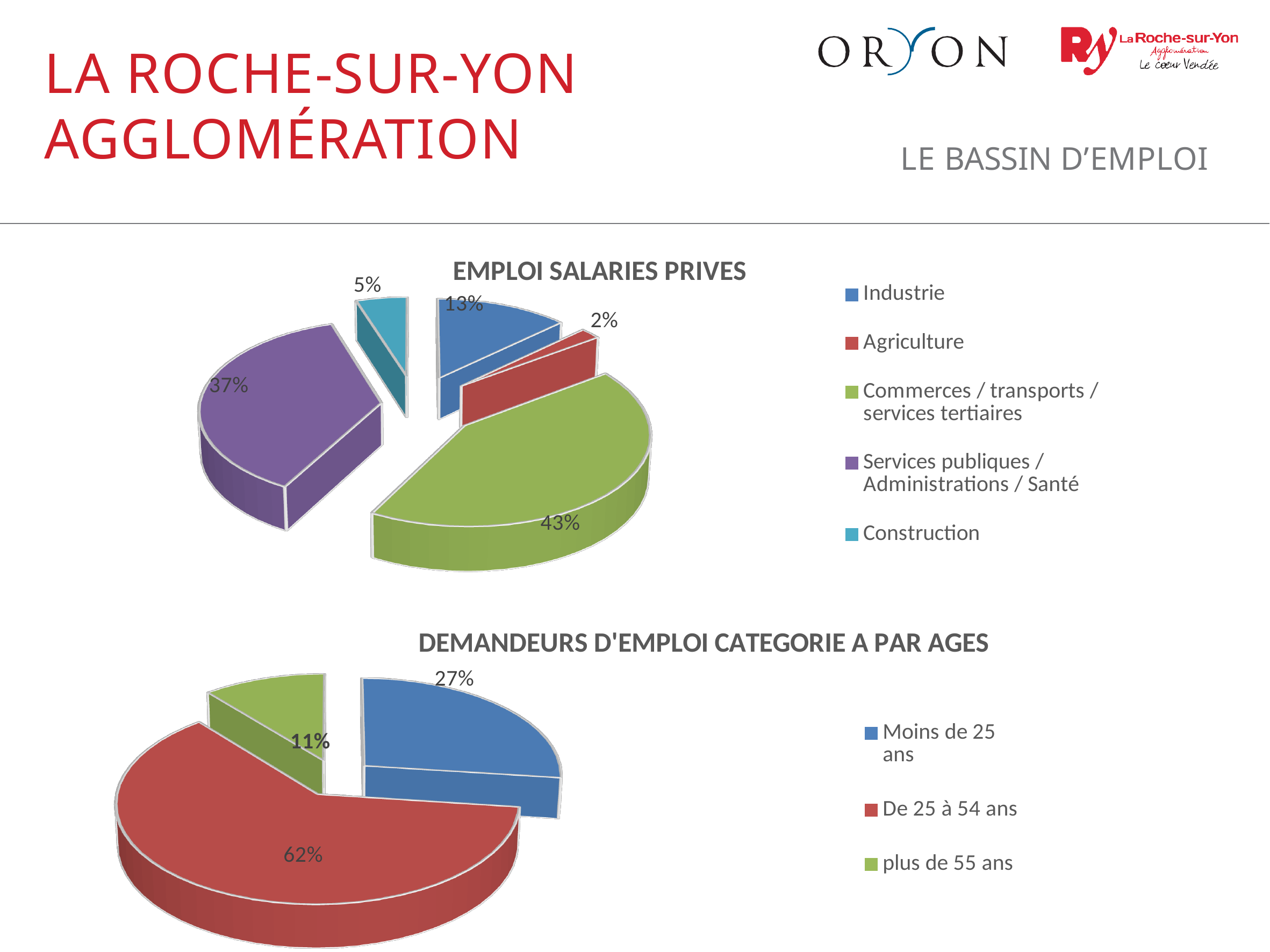
In the 'EMPLOI SALARIES PRIVES' chart, what share does Industrie have? 13% What kind of chart is 'EMPLOI SALARIES PRIVES'? Pie chart In the 'DEMANDEURS D'EMPLOI CATEGORIE A PAR AGES' chart, what share do those aged De 25 à 54 ans have? 62% In the 'DEMANDEURS D'EMPLOI CATEGORIE A PAR AGES' chart, what is the difference between the shares of De 25 à 54 ans and Moins de 25 ans? 35% In the 'EMPLOI SALARIES PRIVES' chart, which category has the largest share? Commerces / transports / services tertiaires In the 'EMPLOI SALARIES PRIVES' chart, what is the difference between the shares of Commerces / transports / services tertiaires and Services publiques / Administrations / Santé? 6% In the 'DEMANDEURS D'EMPLOI CATEGORIE A PAR AGES' chart, what share do those aged plus de 55 ans have? 11% In the 'DEMANDEURS D'EMPLOI CATEGORIE A PAR AGES' chart, which is larger: Moins de 25 ans or plus de 55 ans? Moins de 25 ans In the 'EMPLOI SALARIES PRIVES' chart, which category has the smallest share? Agriculture In the 'EMPLOI SALARIES PRIVES' chart, how many categories does the legend list? 5 In the 'EMPLOI SALARIES PRIVES' chart, what share does Construction have? 5% In the 'DEMANDEURS D'EMPLOI CATEGORIE A PAR AGES' chart, how many age categories are shown? 3